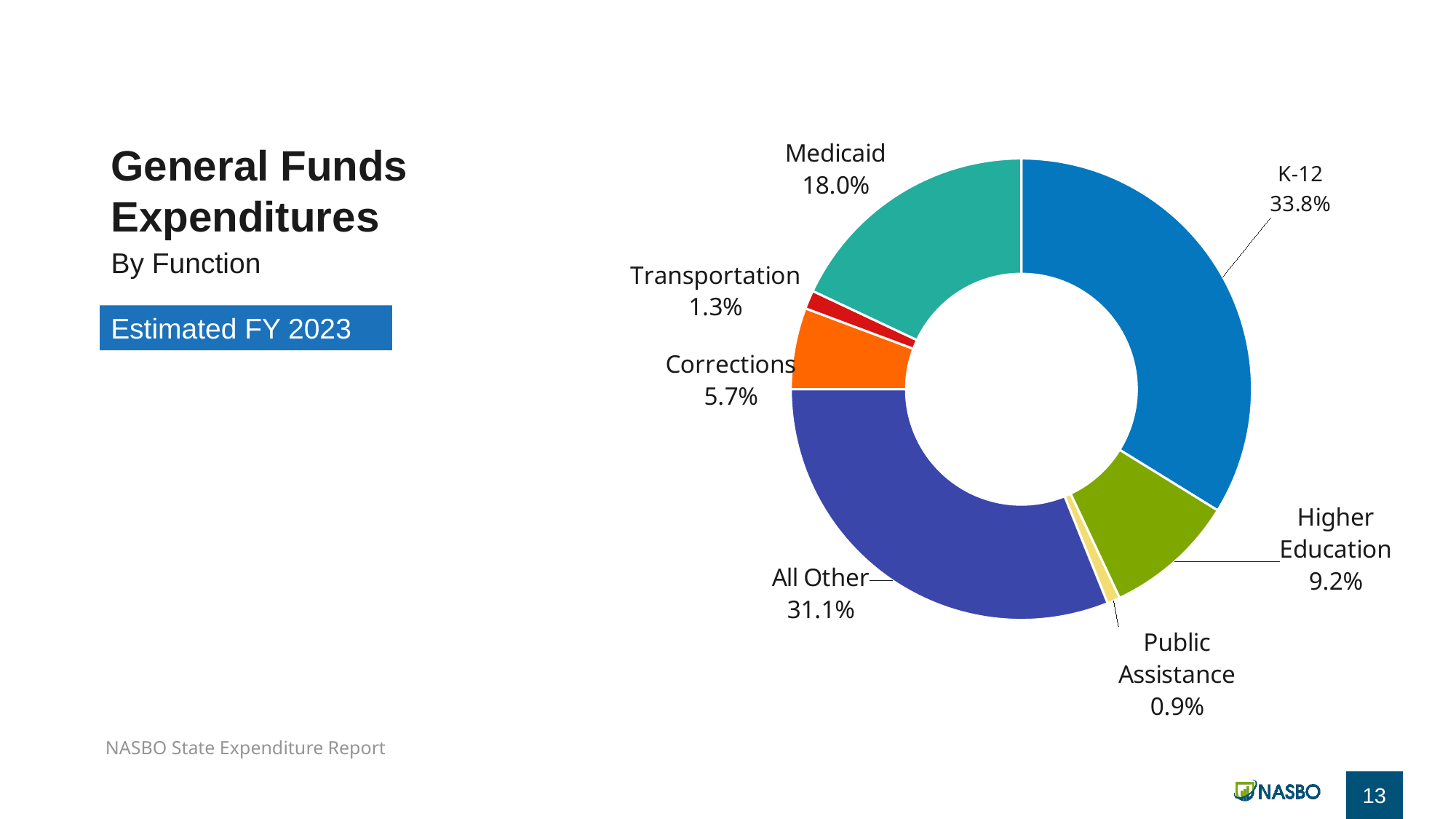
What share is labelled for Public Assistance? 0.9% What is the value shown for Higher Education? 9.2% What fiscal year does the chart cover? Estimated FY 2023 What share of general fund expenditures goes to K-12? 33.8% Which function has the largest share of general fund expenditures? K-12 What is the difference in percentage points between K-12 and All Other? 2.7 How many categories are shown in the chart? 7 Which function has the smallest share of general fund expenditures? Public Assistance What is the combined share of Medicaid and Corrections? 23.7% What percentage of the pie is Medicaid? 18.0% Which is larger, Corrections or Transportation? Corrections What kind of chart is shown on the slide? Pie chart (donut)